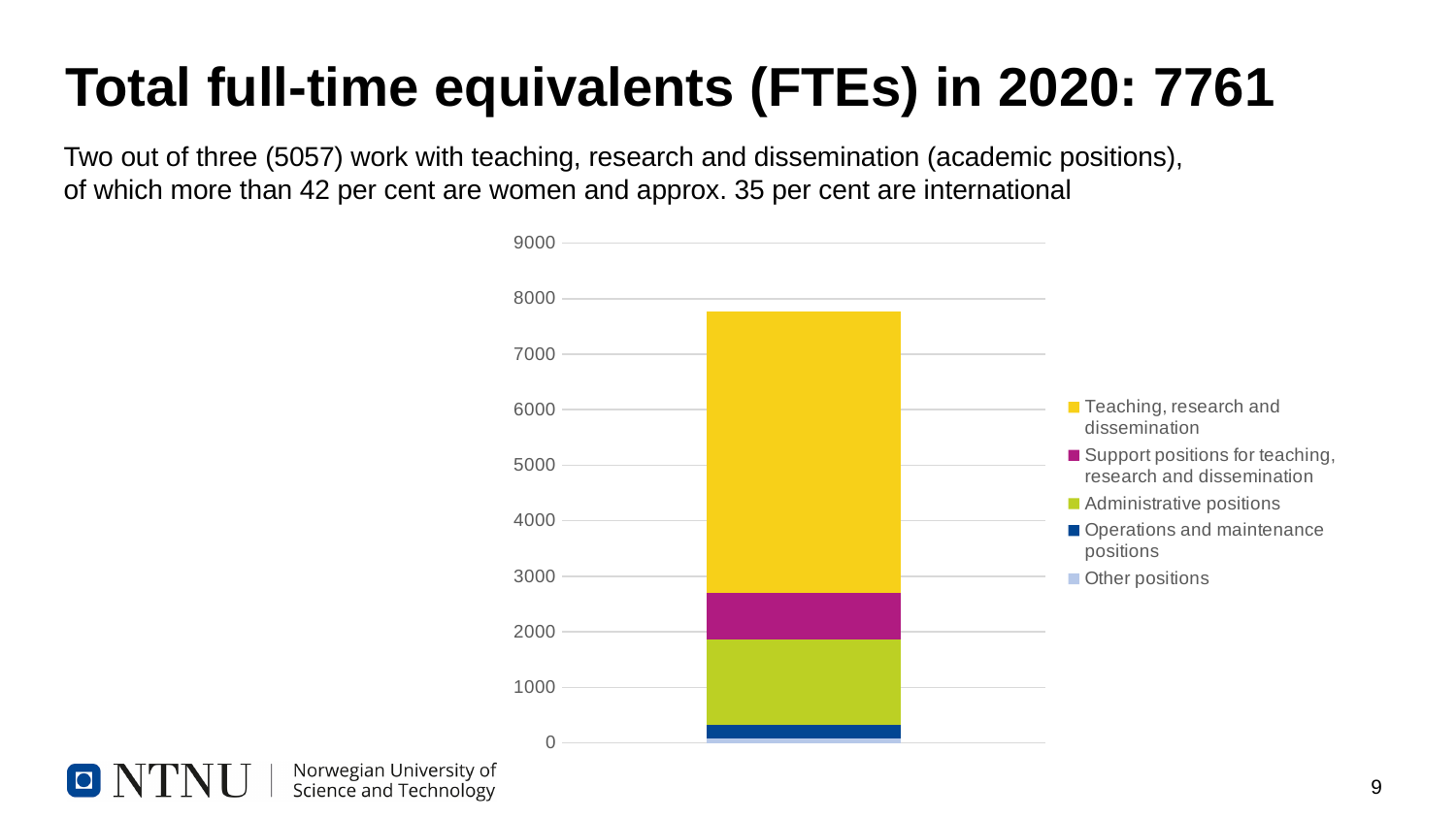
Is the Operations and maintenance positions segment greater or less than 1000? less How many series does the legend list? 5 Is the total height of the stacked bar greater or less than 8000? less How many bars are plotted in the chart? 1 Which segment is larger: Administrative positions or Support positions for teaching, research and dissemination? Administrative positions Which series is listed last in the legend? Other positions According to the slide, what is the total of the stacked bar (total FTEs in 2020)? 7761 Is the Administrative positions segment greater or less than 1000? greater What colour represents Teaching, research and dissemination in the chart? Yellow What kind of chart is shown on the slide? Stacked bar chart Which series makes up the largest segment of the stacked bar? Teaching, research and dissemination